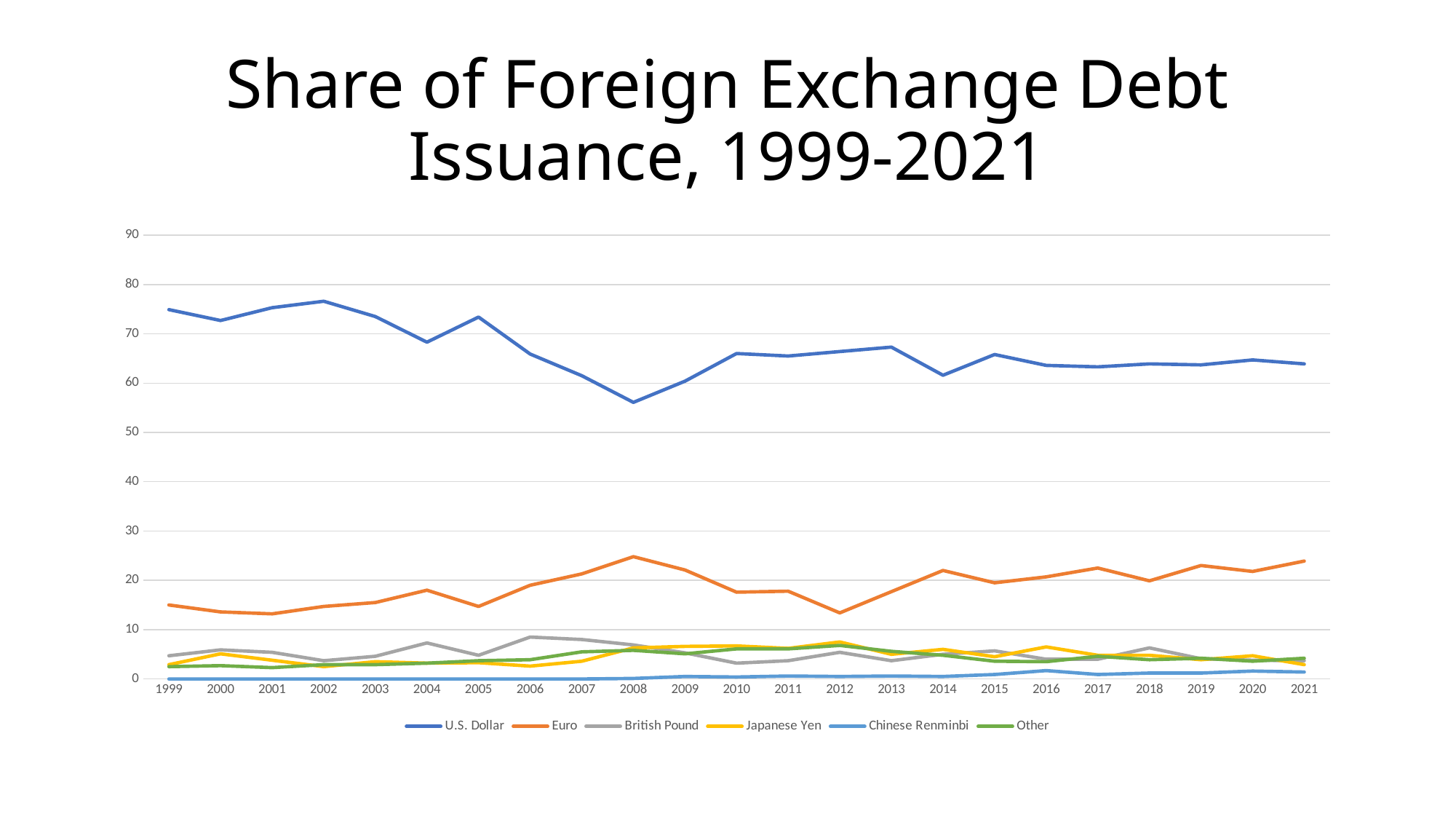
What is the title of the chart? Share of Foreign Exchange Debt Issuance, 1999-2021 Is the value for U.S. Dollar in 2008 greater or less than 60? less In which year does the U.S. Dollar series reach its lowest value? 2008 In which year does the U.S. Dollar series reach its highest value? 2002 Is the value for Euro in 2012 greater or less than 20? less Which is larger in 2021, the U.S. Dollar value or the Euro value? U.S. Dollar How many years are plotted along the x axis? 23 How many series does the legend list? 6 Does the U.S. Dollar series rise or fall between 2002 and 2008? Fall Is the value for U.S. Dollar in 2002 greater or less than 70? greater Which series has the highest values across the whole period? U.S. Dollar What kind of chart is shown on the slide? Line chart